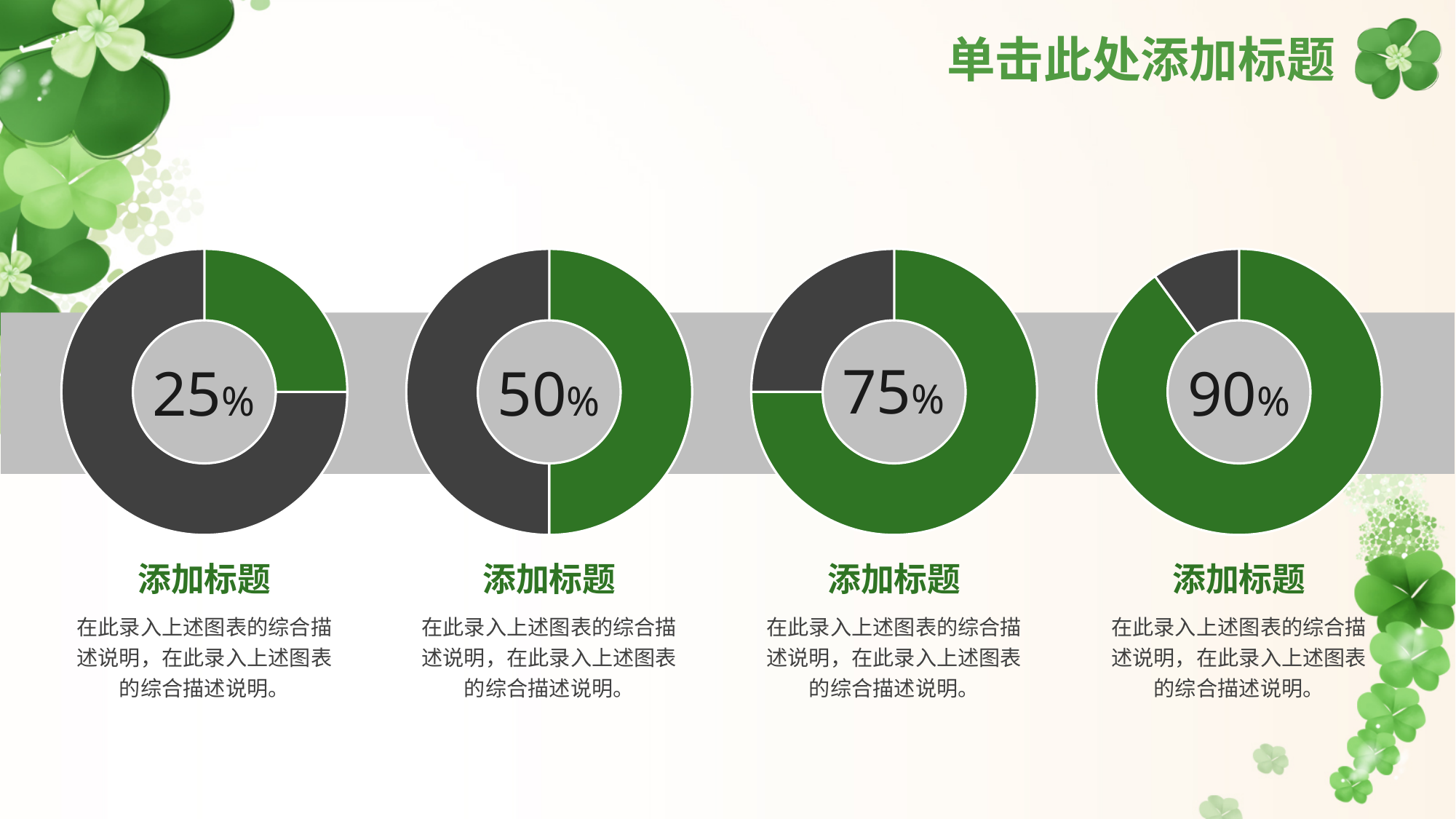
What percentage is shown in the centre of the leftmost donut chart? 25% What is the difference between the percentage in the rightmost donut chart and the percentage in the leftmost donut chart? 65% Which is larger: the percentage in the second donut chart from the left or the percentage in the third donut chart from the left? The third (75%) What percentage is shown in the centre of the third donut chart from the left? 75% What colour is used for the filled (percentage) portion of each donut chart? Green Do the percentages in the donut charts increase or decrease from left to right across the slide? Increase Which donut chart shows the lowest percentage? The leftmost one (25%) How many donut charts are shown on the slide? 4 Which donut chart shows the highest percentage? The rightmost one (90%) What percentage is shown in the centre of the rightmost donut chart? 90% What percentage is shown in the centre of the second donut chart from the left? 50% What kind of chart is used for each of the four figures on the slide? Donut chart